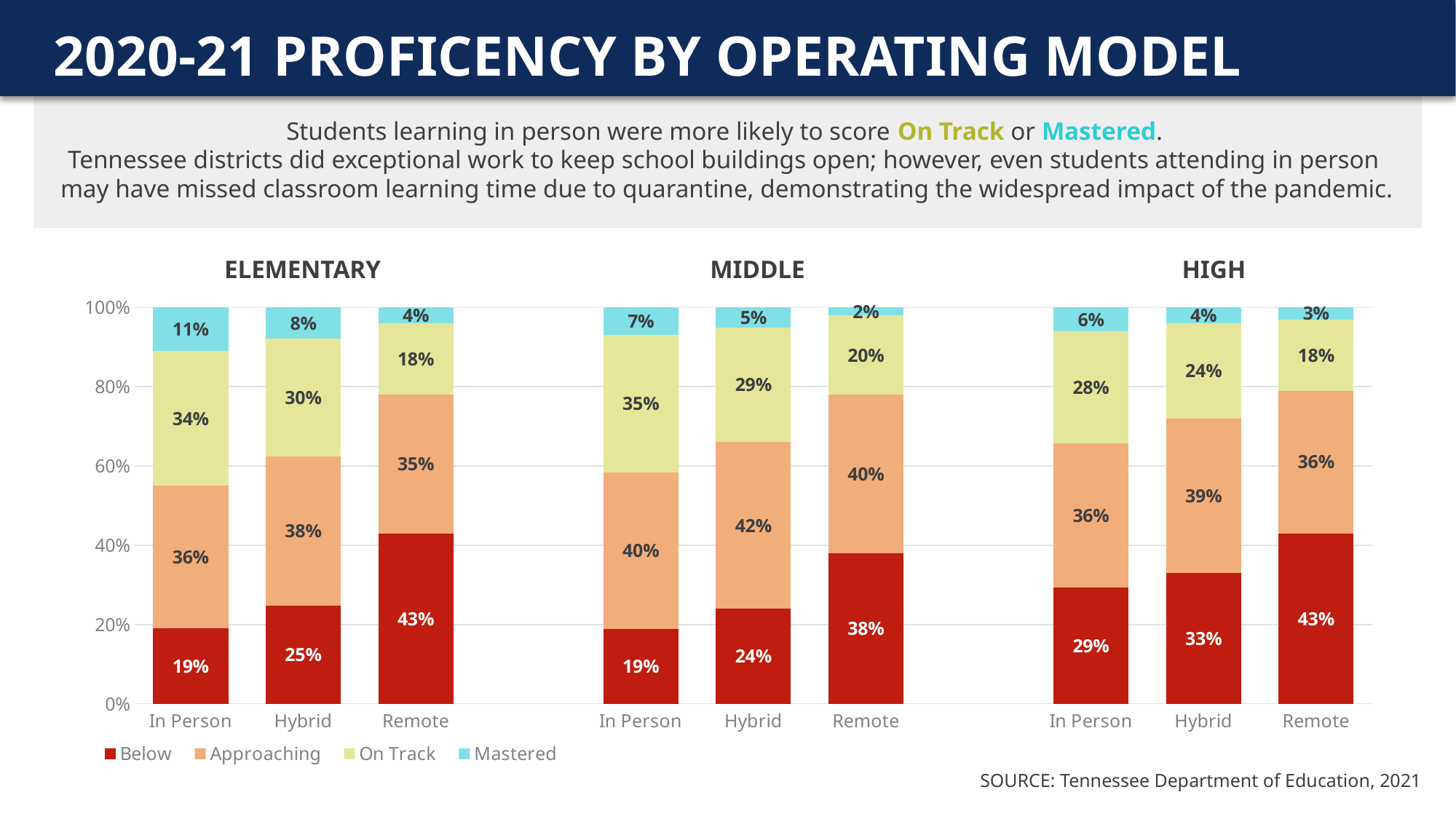
In the High group, which operating model has the highest Below percentage? Remote What source is cited for the chart data? Tennessee Department of Education, 2021 How many stacked bars are plotted in the chart in total? 9 In the Elementary group, how many percentage points higher is the Below share for Remote than for In Person? 24 percentage points In the Elementary group, does the Below percentage rise or fall going from In Person to Hybrid to Remote? Rises In the Middle group, what percentage of Remote students scored Below? 38% In the Middle group, which operating model has the lowest Mastered percentage? Remote In the High group, what percentage of Hybrid students scored Approaching? 39% What kind of chart is shown on the slide? Stacked bar chart In the Elementary group, what percentage of In Person students scored Mastered? 11% How many series does the legend list? 4 Which is larger: the On Track share for Hybrid in the Middle group or the On Track share for Hybrid in the High group? Middle Hybrid